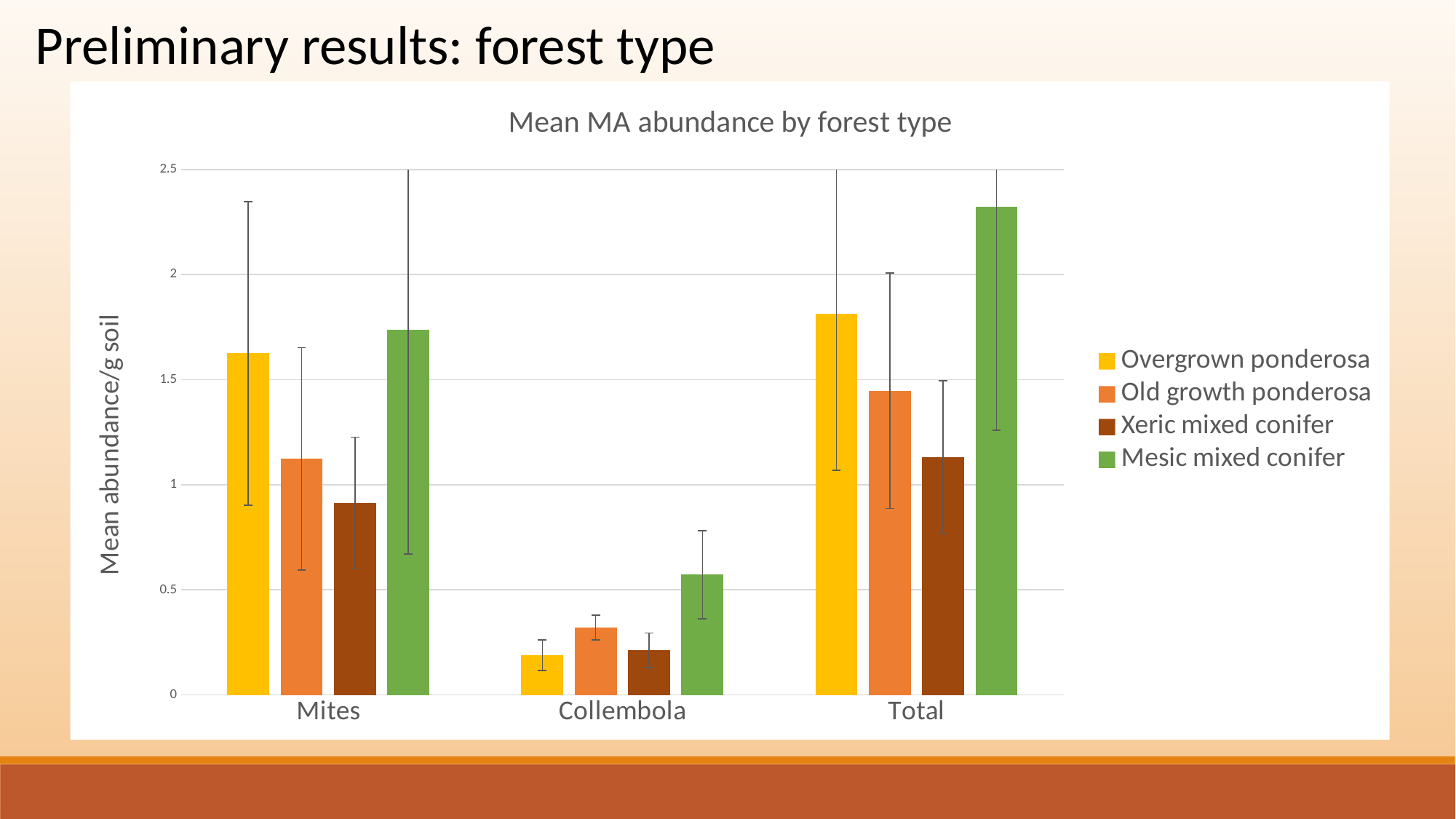
Which forest type has the highest value for Collembola? Mesic mixed conifer Is the value for Overgrown ponderosa in the Mites category greater or less than 1.5? greater How many categories are shown on the x axis? 3 Is the value for Mesic mixed conifer in the Total category greater or less than 2? greater How many series does the legend list? 4 For Mites, which is larger: Old growth ponderosa or Xeric mixed conifer? Old growth ponderosa Which forest type has the lowest value for Mites? Xeric mixed conifer Which forest type has the lowest value for Total? Xeric mixed conifer What is the title of the chart? Mean MA abundance by forest type What kind of chart is shown on the slide? bar chart Is the value for Mesic mixed conifer in the Collembola category greater or less than 0.5? greater Which forest type has the highest value for Total? Mesic mixed conifer